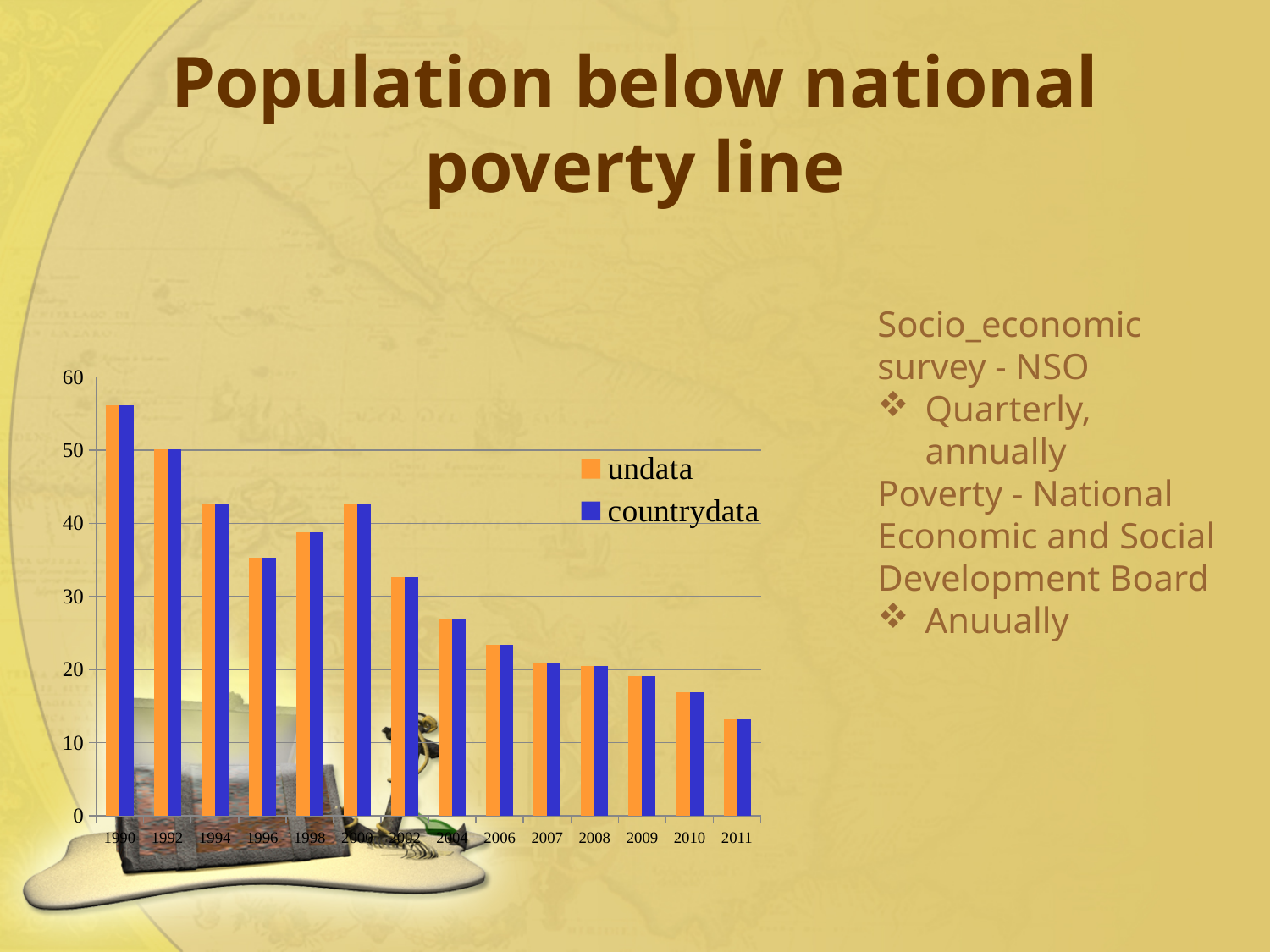
What are the two series named in the legend? undata and countrydata What kind of chart is shown on the slide? bar chart Which year has the highest value in the chart? 1990 Do the values generally rise or fall from 1990 to 2011? fall Is the undata value for 1990 greater or less than 50? greater Which year has the larger undata value, 1996 or 1998? 1998 How many series does the chart legend list? 2 Is the undata value for 2004 greater or less than 30? less Is the countrydata value for 1996 greater or less than 30? greater Which year has the lowest value in the chart? 2011 How many years are shown along the x axis of the chart? 14